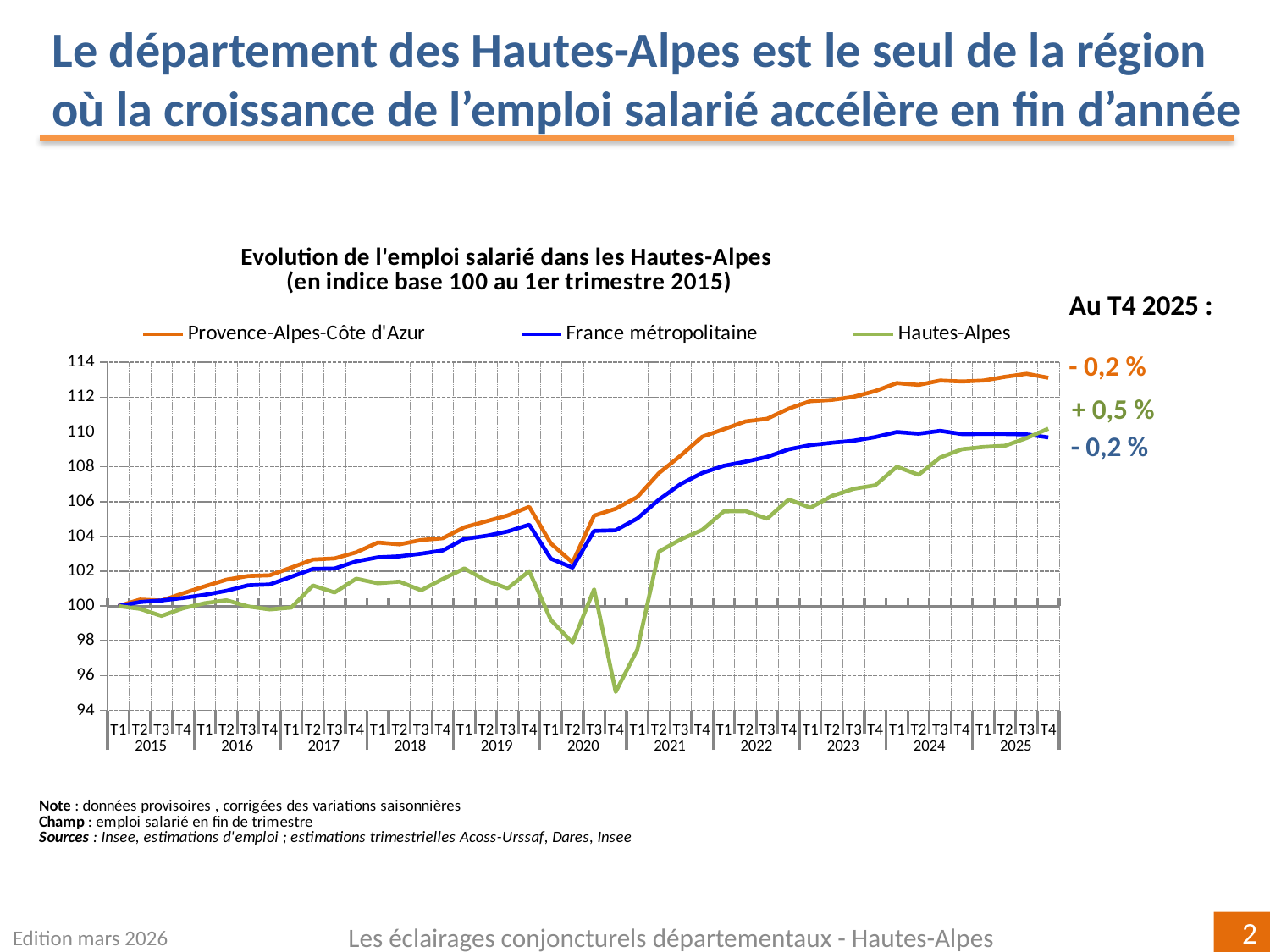
Which series has the highest index value at T4 2025? Provence-Alpes-Côte d'Azur What is the index value of all three series at T1 2015? 100 In which quarter does the Hautes-Alpes series reach its lowest point? T4 2020 What kind of chart is shown on the slide? line chart At T4 2020, which is higher: France métropolitaine or Hautes-Alpes? France métropolitaine How many series does the legend list? 3 Is the value for Hautes-Alpes at T2 2020 greater or less than 100? less Is the value for Hautes-Alpes at T4 2020 greater or less than 98? less Is the value for Provence-Alpes-Côte d'Azur at T4 2025 greater or less than 112? greater According to the annotation on the right, what is the change for Hautes-Alpes at T4 2025? + 0,5 % Does the Provence-Alpes-Côte d'Azur series rise or fall between T1 2021 and T4 2025? rise Which series are listed in the legend? Provence-Alpes-Côte d'Azur, France métropolitaine, Hautes-Alpes